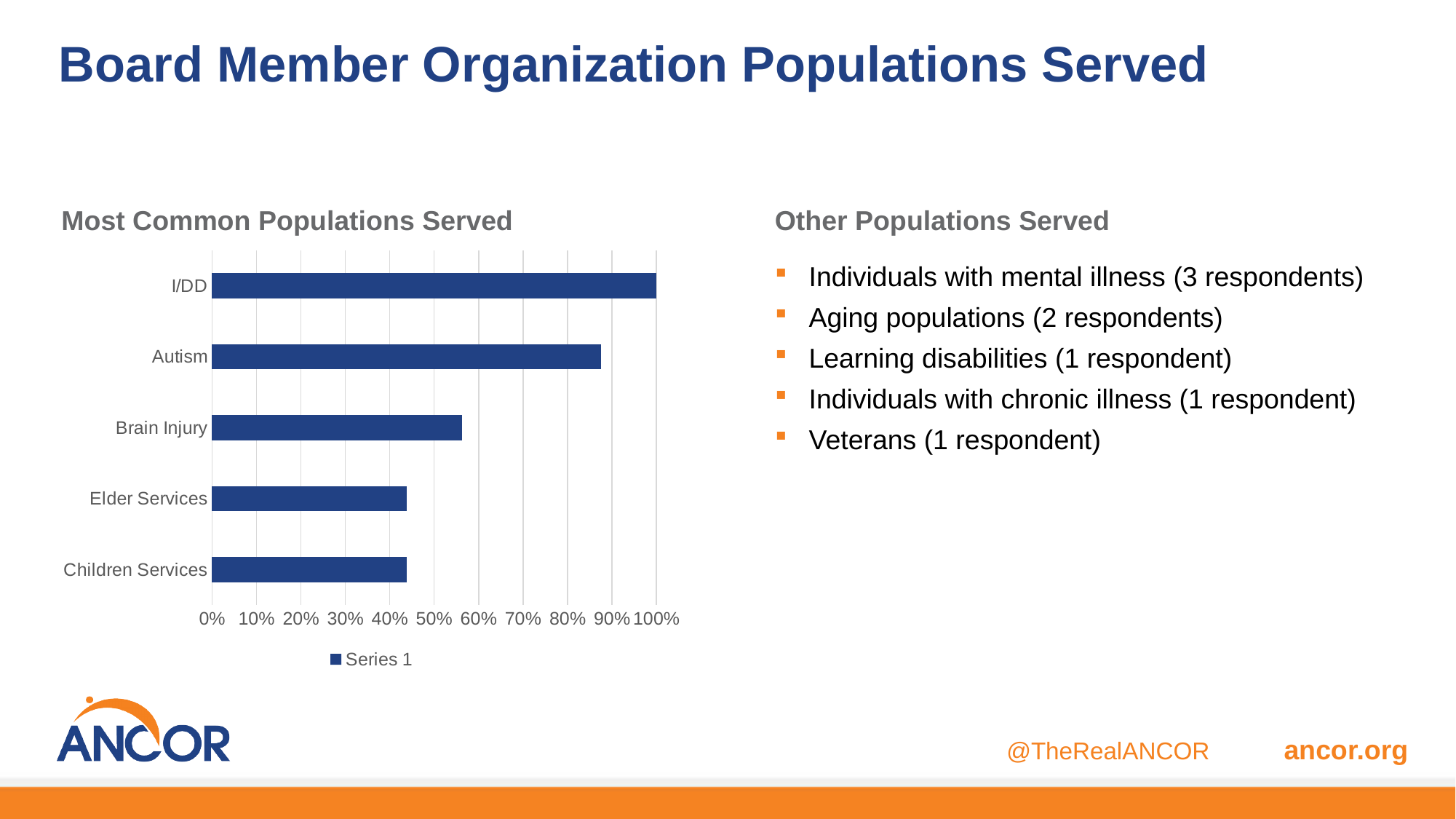
Is the value for Elder Services in the "Most Common Populations Served" chart greater or less than 50%? less Is the value for Autism in the "Most Common Populations Served" chart greater or less than 80%? greater In the "Most Common Populations Served" chart, which is larger: Brain Injury or Elder Services? Brain Injury Which category has the highest value in the "Most Common Populations Served" chart? I/DD In the "Most Common Populations Served" chart, which is larger: Autism or Brain Injury? Autism Is the value for Brain Injury in the "Most Common Populations Served" chart greater or less than 50%? greater What is the value for I/DD in the "Most Common Populations Served" chart? 100% What is the name of the series shown in the legend of the "Most Common Populations Served" chart? Series 1 What type of chart is shown under "Most Common Populations Served"? Bar chart How many categories are shown in the "Most Common Populations Served" chart? 5 How many series does the legend of the "Most Common Populations Served" chart list? 1